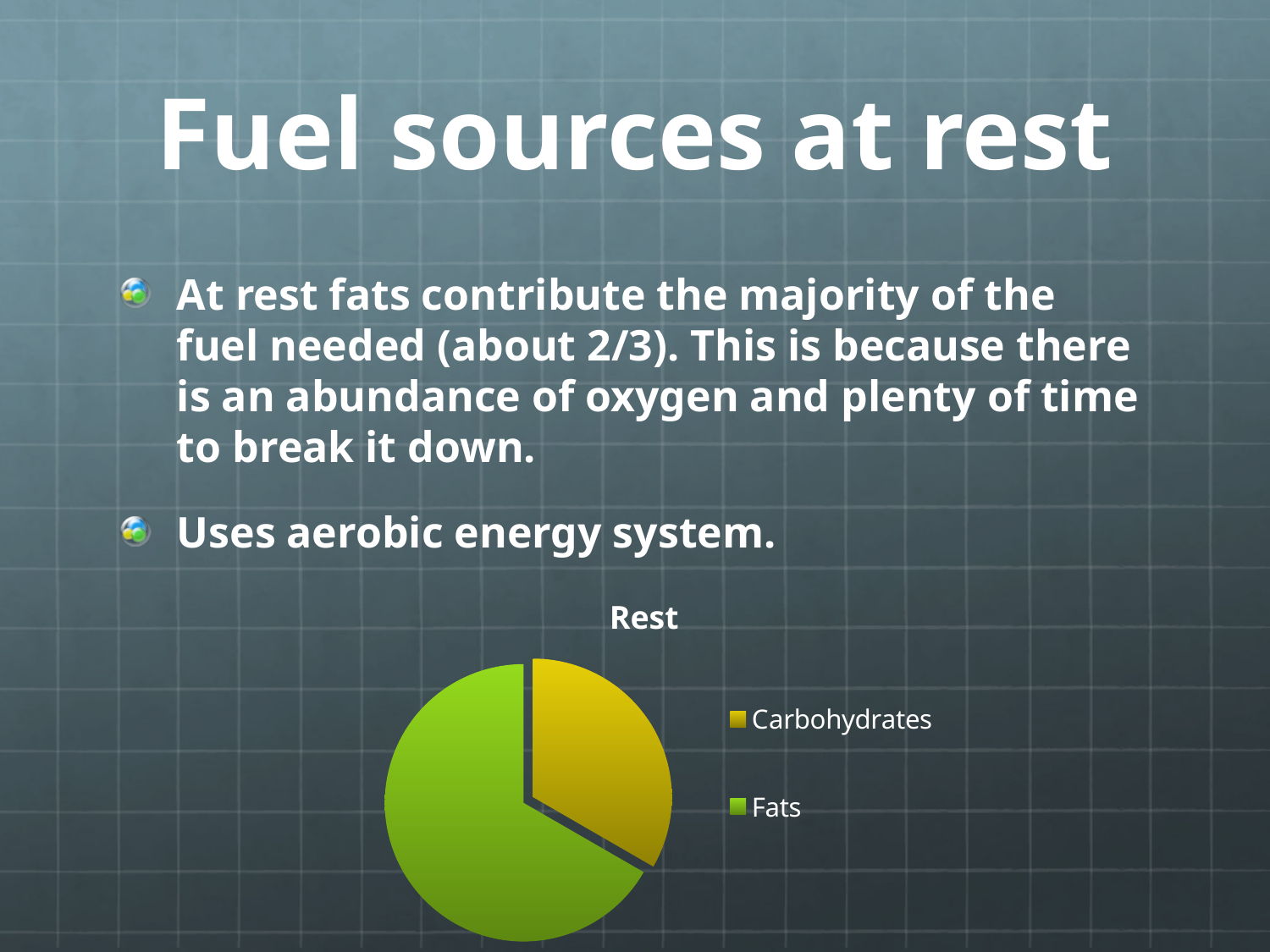
Which fuel source has the largest slice in the pie chart? Fats Which slice is larger in the pie chart, Carbohydrates or Fats? Fats How many slices does the pie chart have? 2 What colour is the Fats slice in the pie chart? green Which legend entry is shown in yellow in the pie chart? Carbohydrates Which fuel source has the smallest slice in the pie chart? Carbohydrates What is the title of the pie chart? Rest What kind of chart is shown on the slide? pie chart How many entries does the legend of the pie chart list? 2